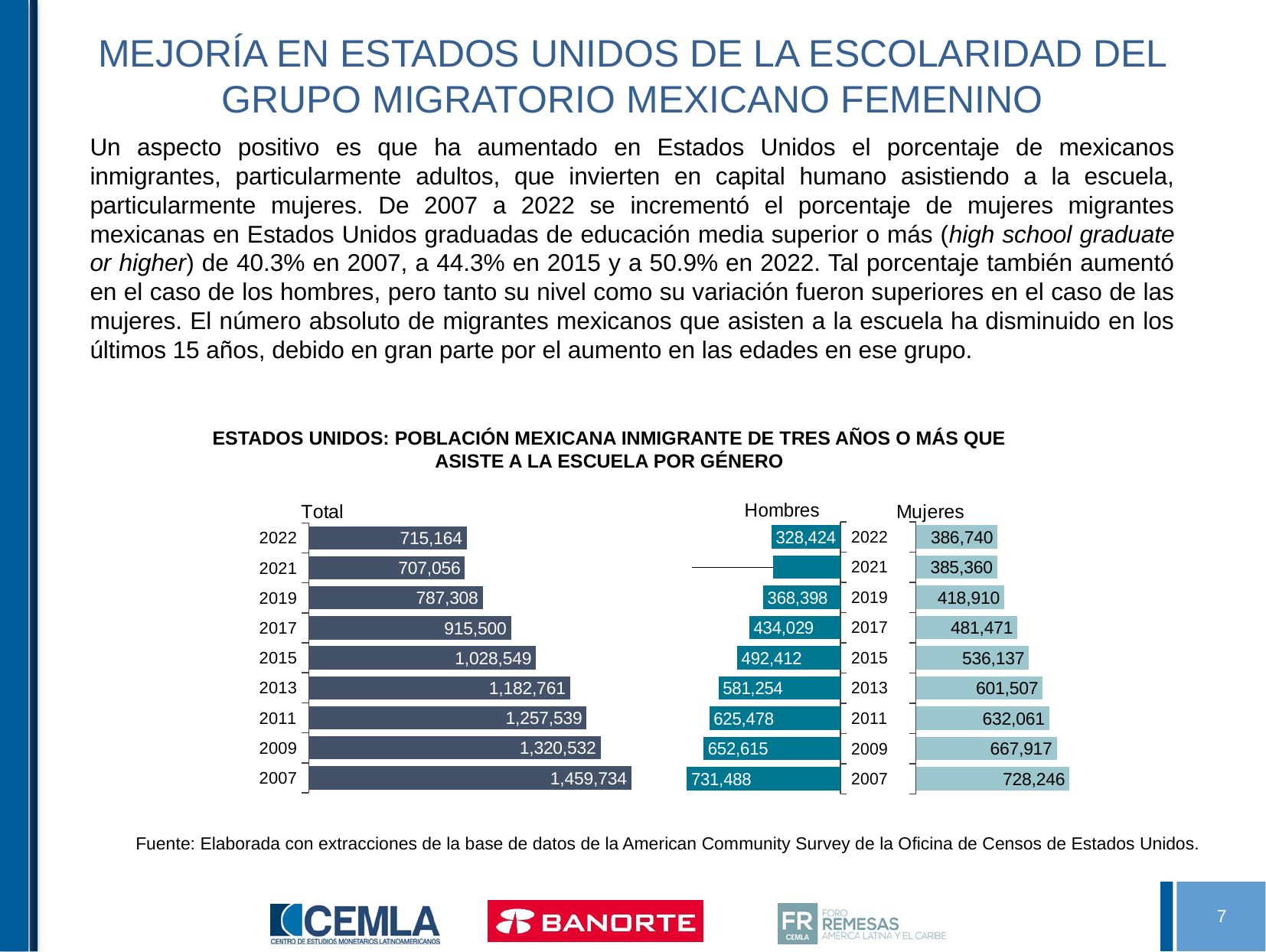
In the Mujeres chart, which year has the lowest value? 2021 In the Total chart, what is the difference between the 2007 value and the 2022 value? 744,570 Which is larger: the Mujeres value for 2019 or the Hombres value for 2019? Mujeres (418,910) What kind of chart is the Total chart? Bar chart What is the difference between the Mujeres value for 2022 and the Hombres value for 2022? 58,316 In the Total chart, which year has the highest value? 2007 How many years are shown in the Total chart? 9 In the Hombres chart, what is the value for 2007? 731,488 In the Total chart, what is the value for 2022? 715,164 In the Total chart, do the values rise or fall from 2007 to 2022? Fall In the Mujeres chart, what is the value for 2015? 536,137 In the Hombres chart, which year has the lowest value? 2021